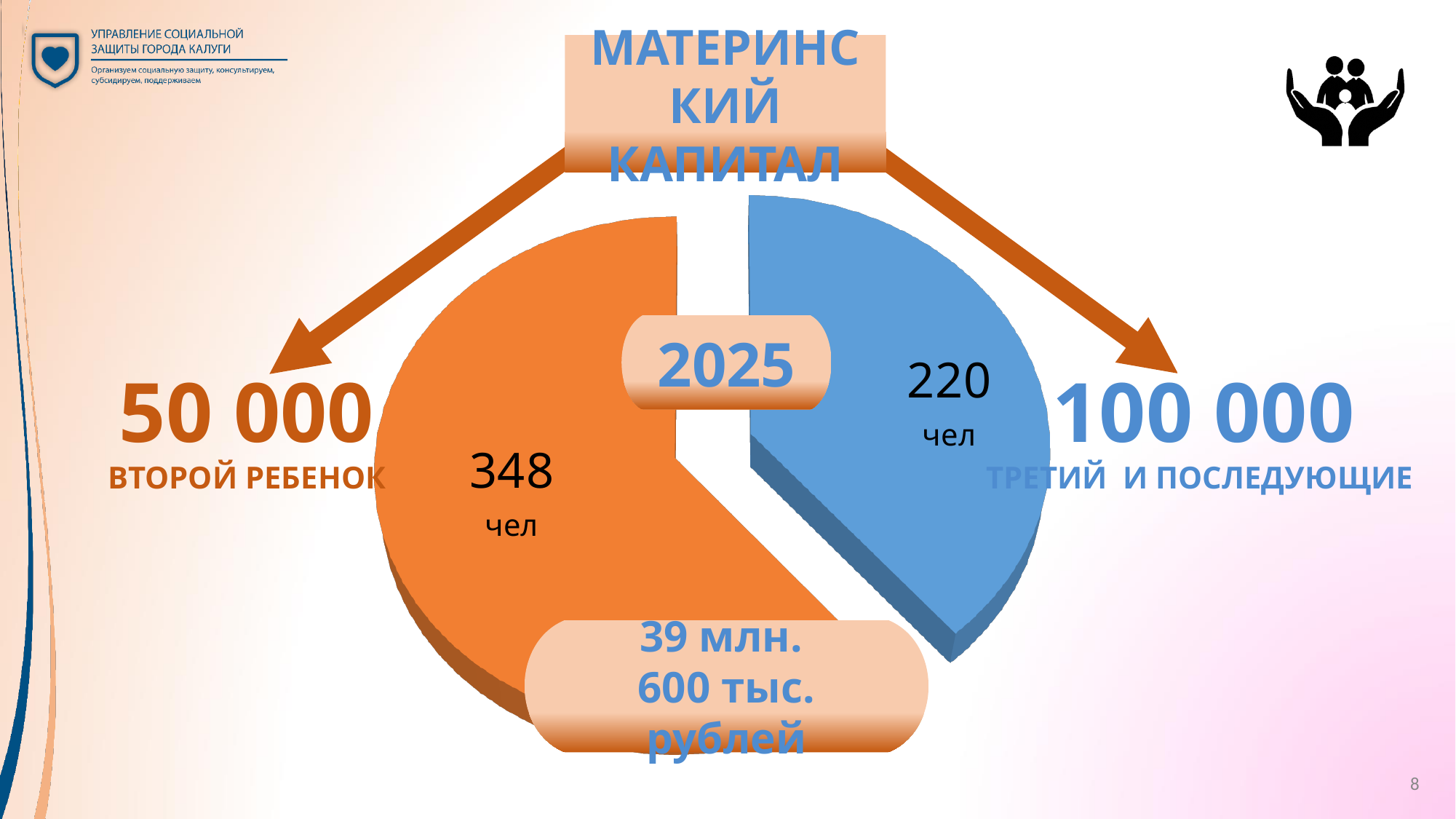
How many slices does the pie chart have? 2 Which slice of the pie chart is the smallest? третий и последующие (220 чел) What is the difference in people between the второй ребенок slice and the третий и последующие slice? 128 чел What year is shown in the centre of the pie chart? 2025 How many people (чел) are shown for the orange slice (второй ребенок)? 348 чел What total amount in rubles is shown below the pie chart? 39 млн. 600 тыс. рублей What is the total number of people across both slices of the pie chart? 568 чел Which slice of the pie chart is the largest? второй ребенок (348 чел) What kind of chart is shown on the slide? pie chart Which is larger: the number of people for второй ребенок or for третий и последующие? второй ребенок How many people (чел) are shown for the blue slice (третий и последующие)? 220 чел